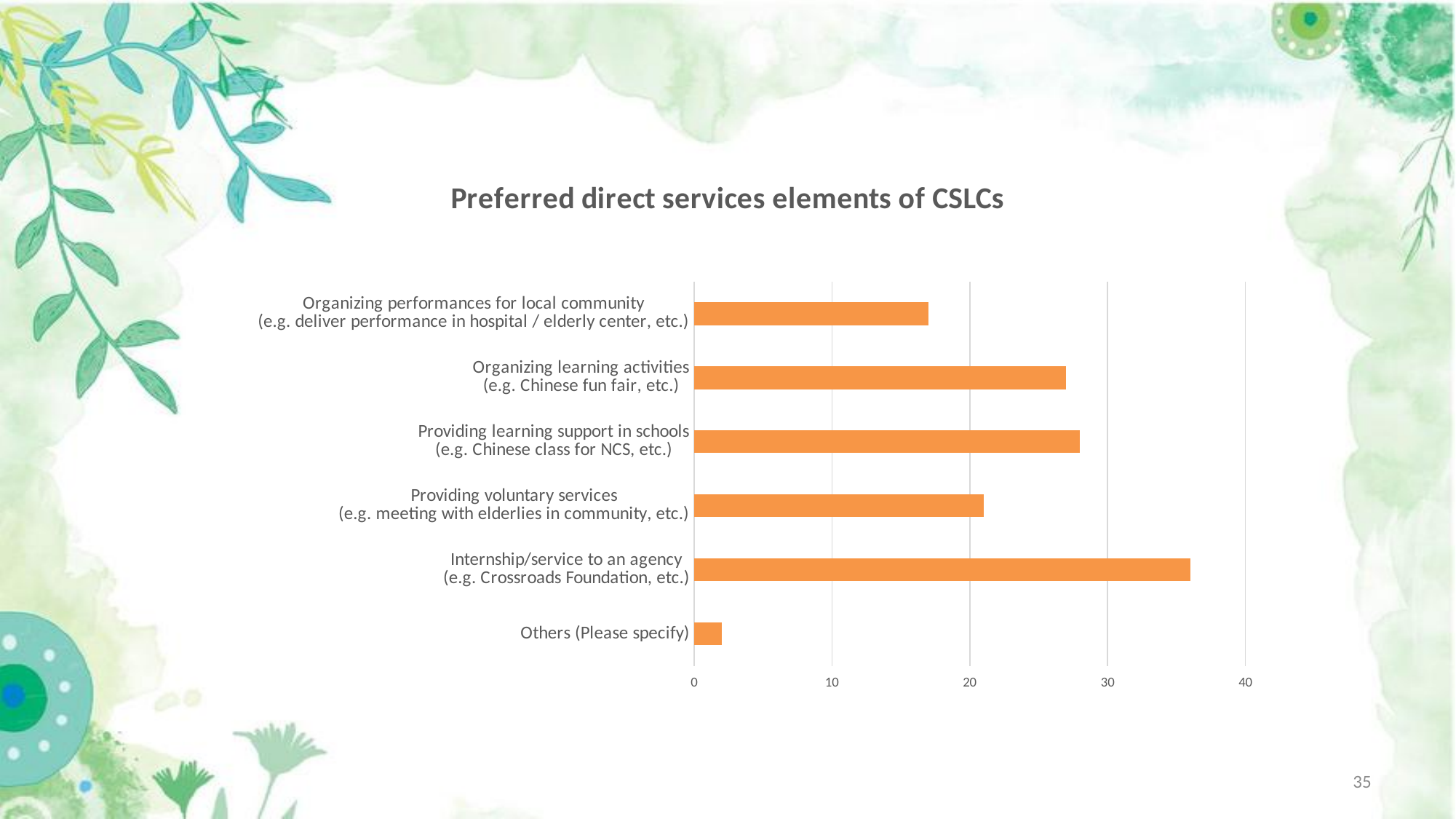
Which category has the lowest value? Others (Please specify) Is the value for Others (Please specify) greater or less than 10? less Which category has the highest value? Internship/service to an agency (e.g. Crossroads Foundation, etc.) Is the value for Internship/service to an agency greater or less than 30? greater What is the title of the chart? Preferred direct services elements of CSLCs What kind of chart is shown on the slide? Bar chart Which is larger: the value for Organizing performances for local community or the value for Providing learning support in schools? Providing learning support in schools Is the value for Providing voluntary services greater or less than 20? greater What colour are the bars in the chart? Orange How many categories are plotted in the chart? 6 Which is larger: the value for Organizing learning activities or the value for Providing voluntary services? Organizing learning activities